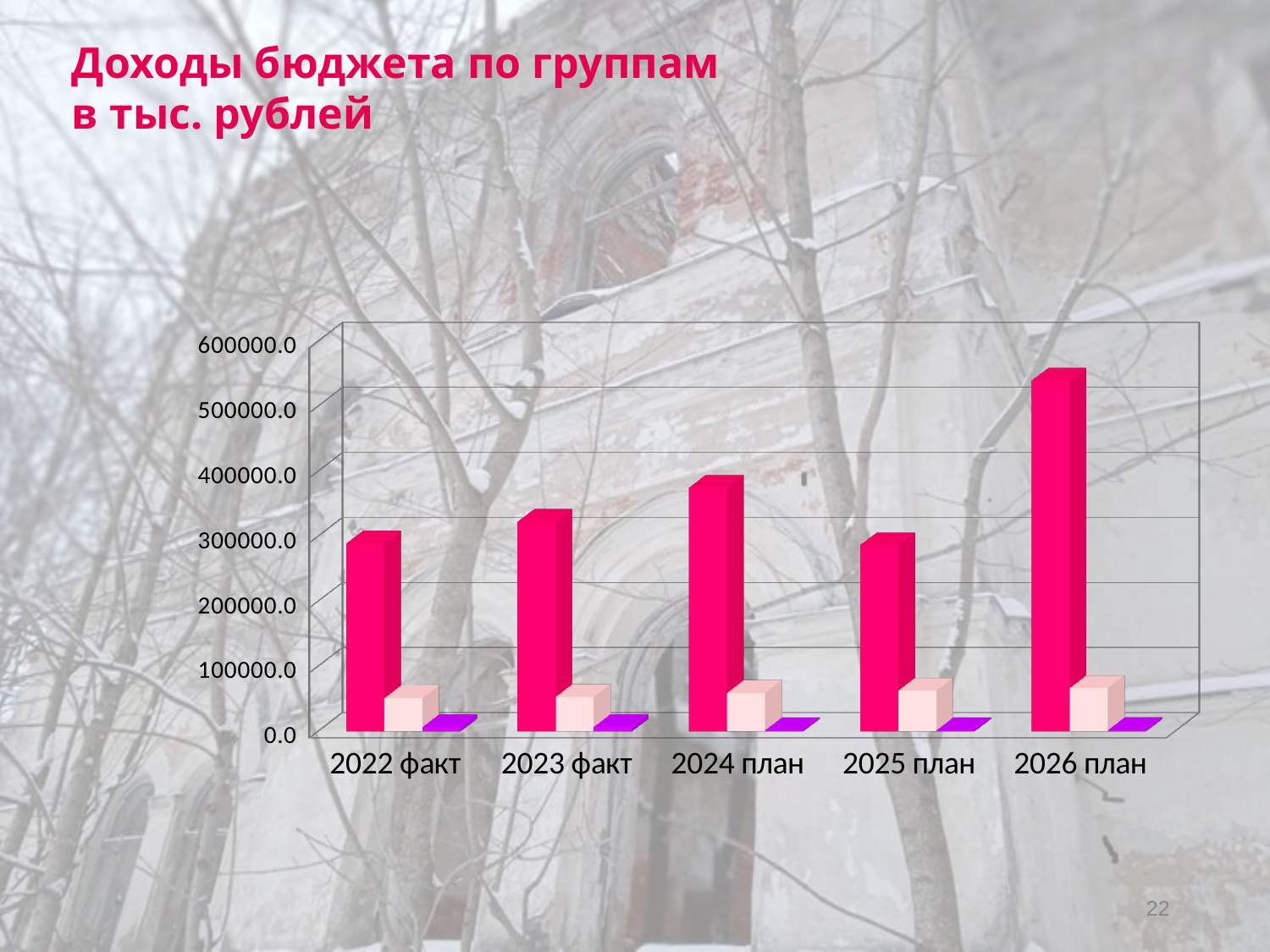
What is the highest value shown on the chart's vertical axis? 600000.0 Is the value of the tallest bar for 2024 план greater or less than 300000.0? greater What kind of chart is shown on the slide? Bar chart Which has the larger tallest bar, 2022 факт or 2026 план? 2026 план How many bars are shown for each category on the chart? 3 Which has the larger tallest bar, 2024 план or 2025 план? 2024 план Is the value of the tallest bar for 2025 план greater or less than 400000.0? less Which category has the tallest bar on the chart? 2026 план Is the value of the tallest bar for 2023 факт greater or less than 400000.0? less What is the title of the slide containing the chart? Доходы бюджета по группам в тыс. рублей How many categories are shown on the x axis of the chart? 5